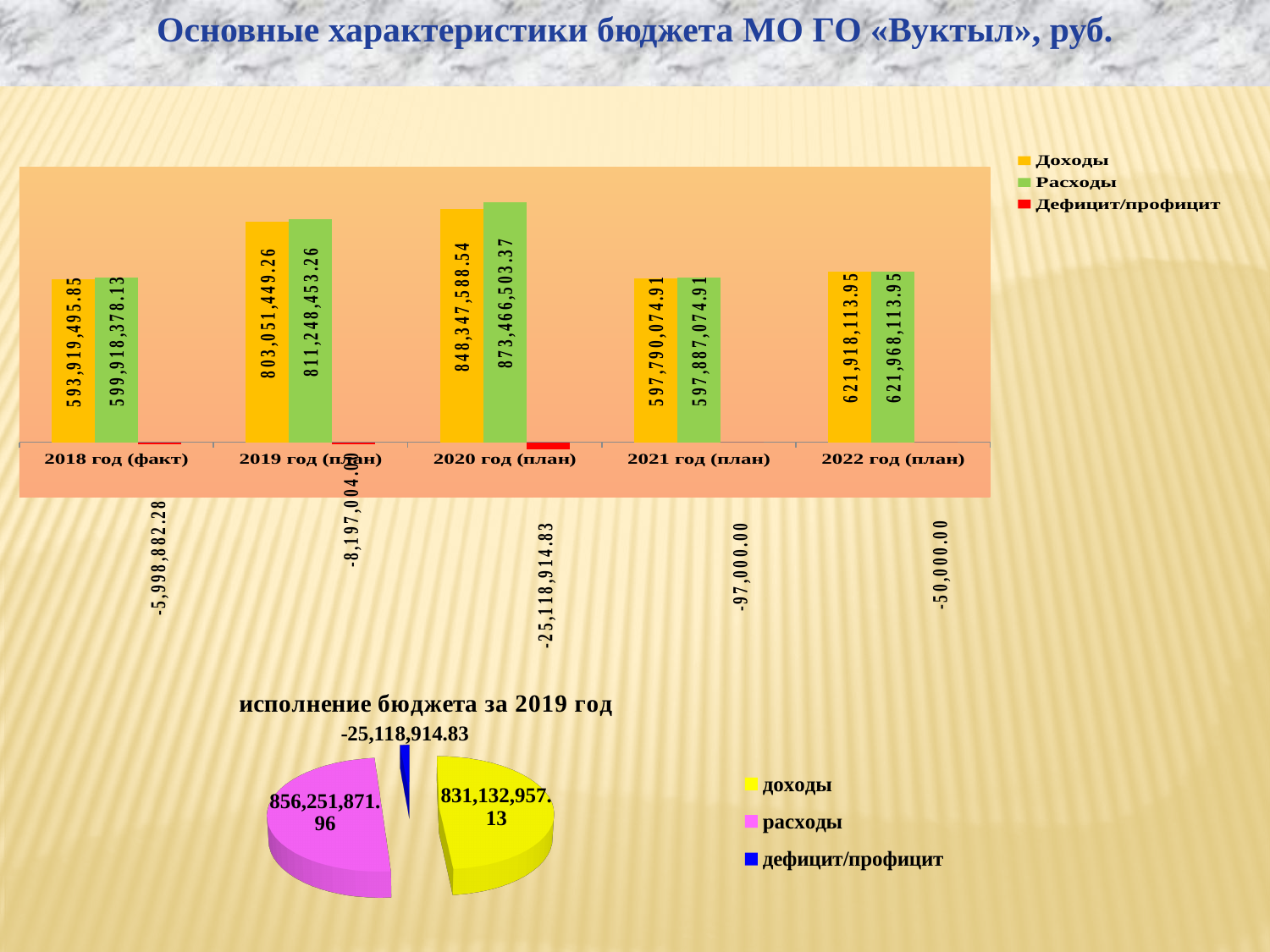
In the bar chart, what is the value of Дефицит/профицит for 2021 год (план)? -97,000.00 In the bar chart, what is the value of Доходы for 2018 год (факт)? 593,919,495.85 In the bar chart, which year has the lowest Расходы? 2018 год (факт) In the bar chart, what is the value of Доходы for 2022 год (план)? 621,918,113.95 How many series does the legend of the bar chart list? 3 In the bar chart, what is the difference between Расходы and Доходы for 2022 год (план)? 50,000.00 In the bar chart, what is the value of Расходы for 2020 год (план)? 873,466,503.37 In the pie chart 'исполнение бюджета за 2019 год', what is the value of расходы? 856,251,871.96 What type of chart is the chart titled 'исполнение бюджета за 2019 год'? pie chart In the bar chart, which is larger for 2019 год (план): Доходы or Расходы? Расходы How many year categories are shown on the x axis of the bar chart? 5 In the bar chart, which year has the highest Доходы? 2020 год (план)